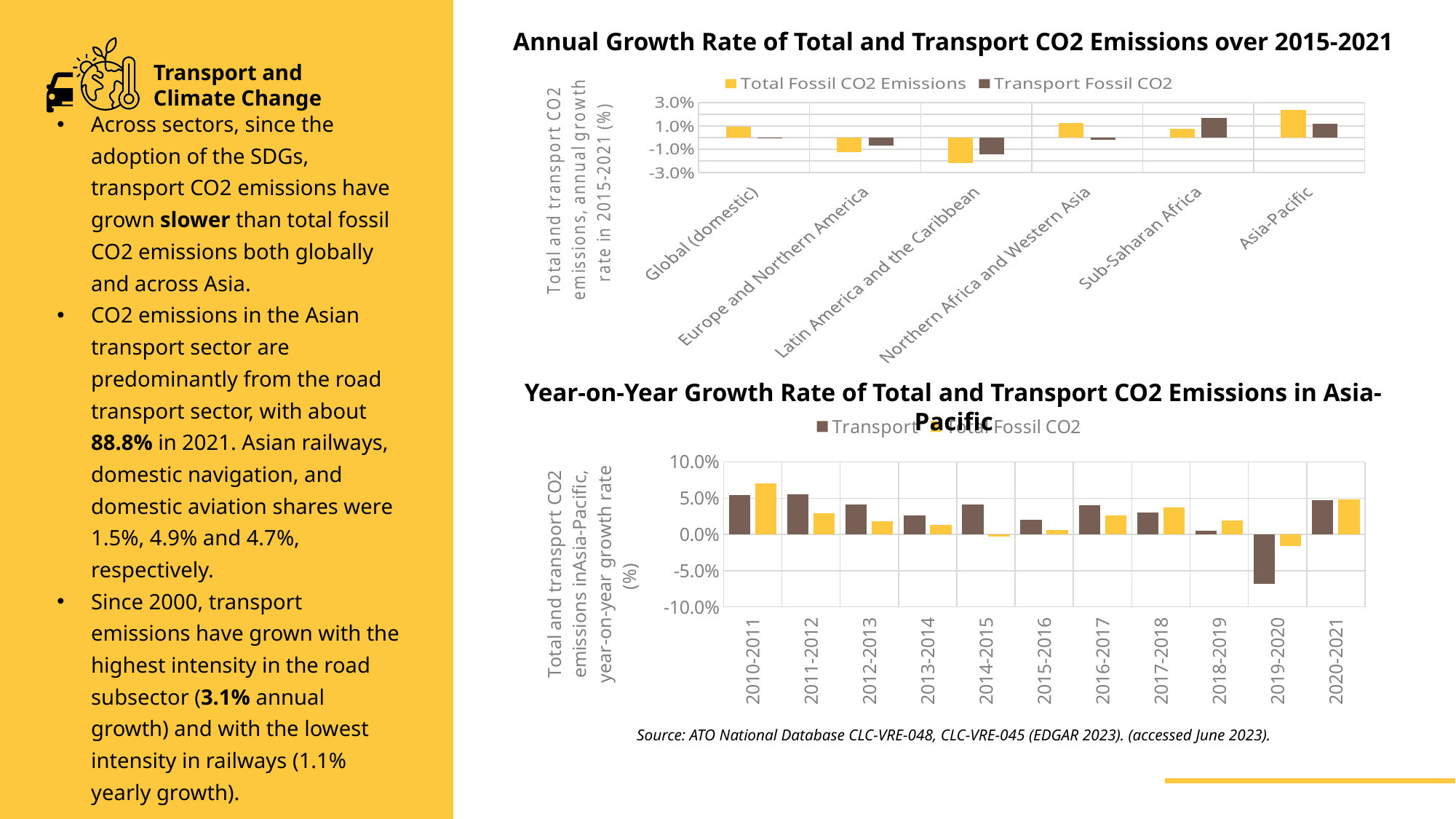
In the top chart, 'Annual Growth Rate of Total and Transport CO2 Emissions over 2015-2021', which region has the highest Transport Fossil CO2 growth rate? Sub-Saharan Africa In the top chart, 'Annual Growth Rate of Total and Transport CO2 Emissions over 2015-2021', is the Total Fossil CO2 Emissions value for Asia-Pacific greater or less than 1.0%? greater In the bottom chart, 'Year-on-Year Growth Rate of Total and Transport CO2 Emissions in Asia-Pacific', which period has the highest Total Fossil CO2 growth rate? 2010-2011 In the bottom chart, 'Year-on-Year Growth Rate of Total and Transport CO2 Emissions in Asia-Pacific', is the Transport value for 2019-2020 greater or less than -5.0%? less In the top chart, 'Annual Growth Rate of Total and Transport CO2 Emissions over 2015-2021', for Asia-Pacific, which is larger: Total Fossil CO2 Emissions or Transport Fossil CO2? Total Fossil CO2 Emissions How many regions are shown on the x axis of the top chart, 'Annual Growth Rate of Total and Transport CO2 Emissions over 2015-2021'? 6 How many series does the legend of the top chart, 'Annual Growth Rate of Total and Transport CO2 Emissions over 2015-2021', list? 2 In the top chart, 'Annual Growth Rate of Total and Transport CO2 Emissions over 2015-2021', which region has the highest Total Fossil CO2 Emissions growth rate? Asia-Pacific What kind of chart is the bottom chart, 'Year-on-Year Growth Rate of Total and Transport CO2 Emissions in Asia-Pacific'? bar chart In the top chart, 'Annual Growth Rate of Total and Transport CO2 Emissions over 2015-2021', is the Total Fossil CO2 Emissions value for Latin America and the Caribbean greater or less than -1.0%? less In the bottom chart, 'Year-on-Year Growth Rate of Total and Transport CO2 Emissions in Asia-Pacific', which period has the lowest Transport growth rate? 2019-2020 In the top chart, 'Annual Growth Rate of Total and Transport CO2 Emissions over 2015-2021', which region has the lowest Total Fossil CO2 Emissions growth rate? Latin America and the Caribbean